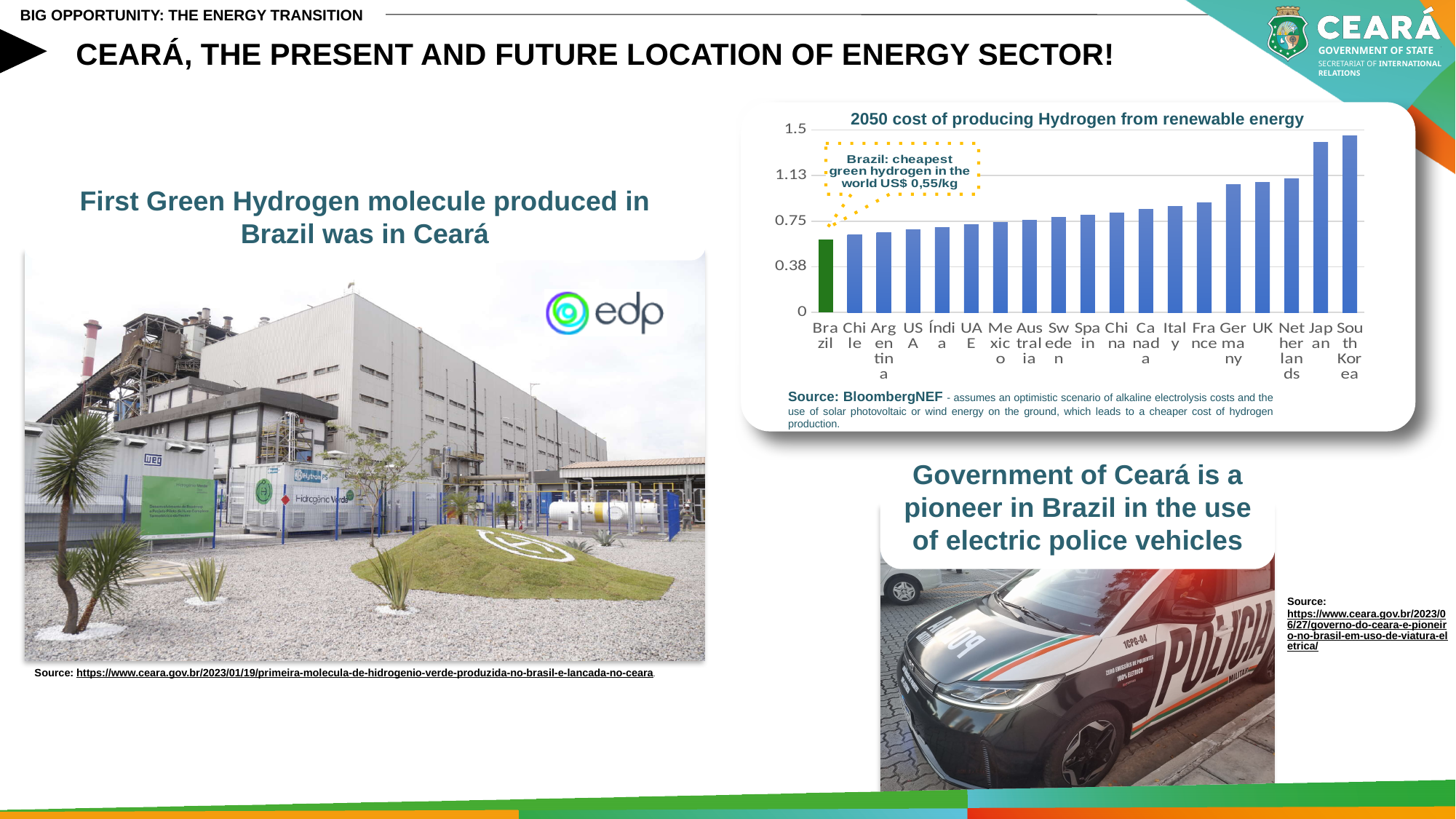
Is the value for Germany greater or less than 0.75? greater Which country's bar is coloured green instead of blue in the chart? Brazil Is the value for Chile greater or less than 0.75? less Which country has the lowest cost of producing hydrogen in the chart? Brazil Which has a higher cost of producing hydrogen, Japan or Germany? Japan What is the title of the chart on the slide? 2050 cost of producing Hydrogen from renewable energy According to the callout on the chart, what is Brazil's cost of green hydrogen? US$ 0,55/kg Do the values in the chart rise or fall from left to right along the x axis? Rise Is the value for Japan greater or less than 1.13? greater Which country has the highest cost of producing hydrogen in the chart? South Korea How many countries are shown in the chart? 19 What kind of chart is shown on the slide? Bar chart